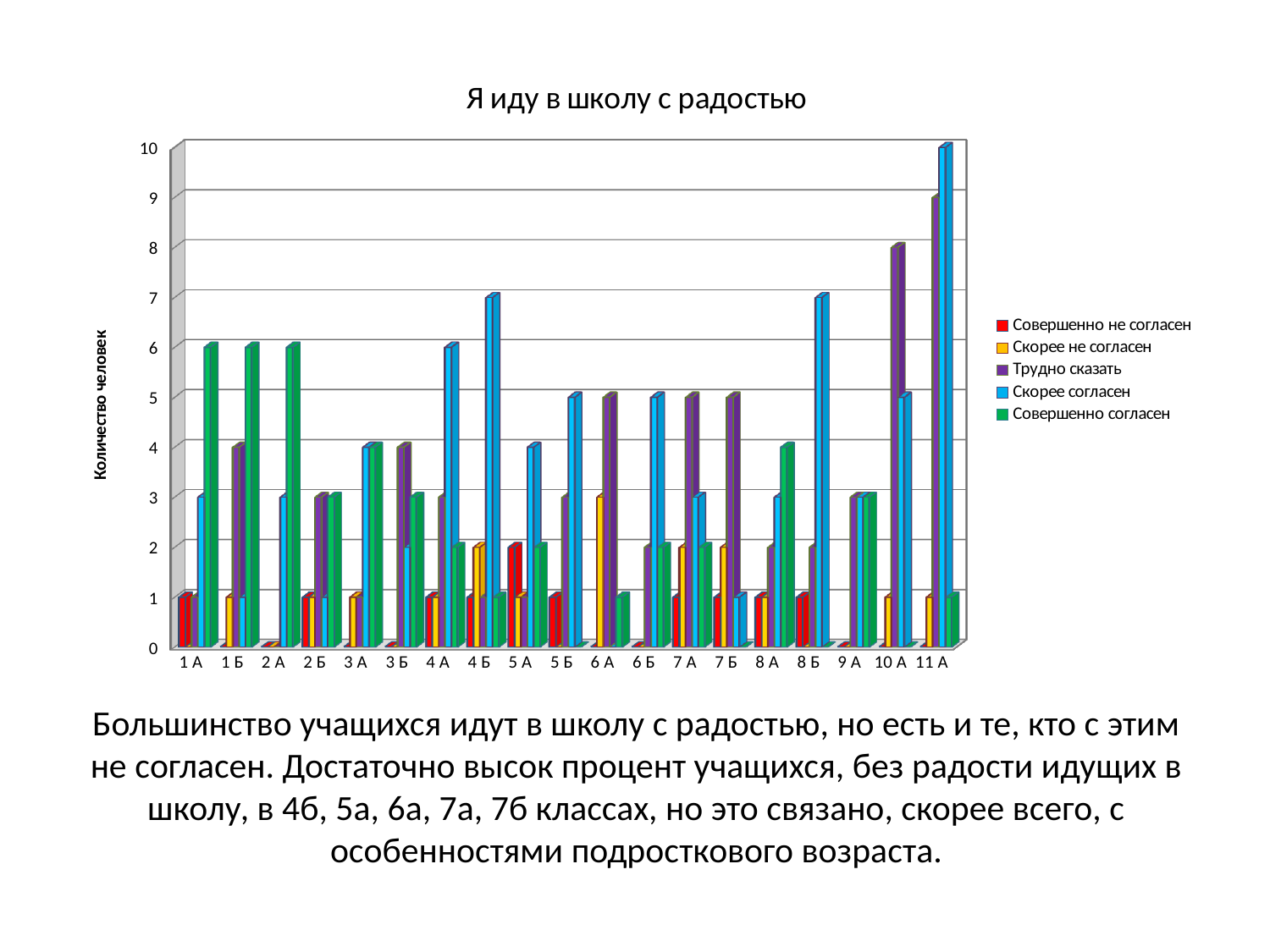
Which is larger for class 2 А: "Скорее согласен" or "Совершенно согласен"? Совершенно согласен How many classes (categories) are shown on the x axis? 19 What kind of chart is shown on the slide? bar chart What is the label of the vertical axis? Количество человек Is the value for "Скорее согласен" in class 11 А greater or less than 8? greater Is the value for "Совершенно согласен" in class 6 А greater or less than 3? less How many series does the legend list? 5 What is the title of the chart? Я иду в школу с радостью Is the value for "Скорее согласен" in class 4 Б greater or less than 5? greater Which class has the tallest bar for "Скорее согласен"? 11 А Which class has the larger "Скорее согласен" value: 1 А or 11 А? 11 А